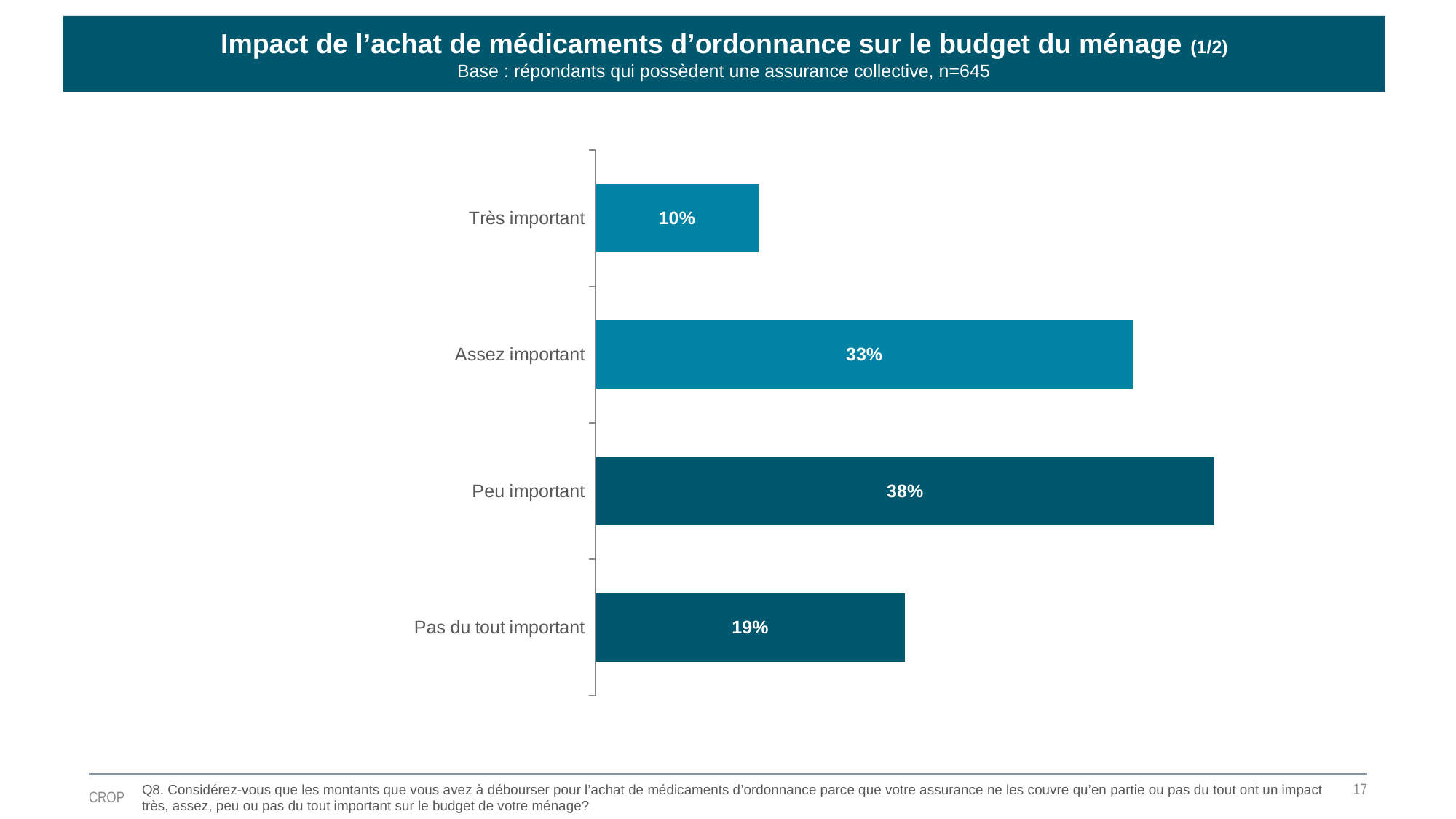
What is the value for "Assez important"? 33% What is the value for "Pas du tout important"? 19% Which is larger, the value for "Assez important" or the value for "Pas du tout important"? Assez important What is the base (n) stated in the chart's subtitle? n=645 Which category has the lowest value? Très important What is the value for "Peu important"? 38% How many categories are shown in the chart? 4 What is the difference between the values for "Pas du tout important" and "Très important"? 9% What kind of chart is shown on the slide? Bar chart What is the value for "Très important"? 10% What is the difference between the values for "Peu important" and "Assez important"? 5% Which category has the highest value? Peu important